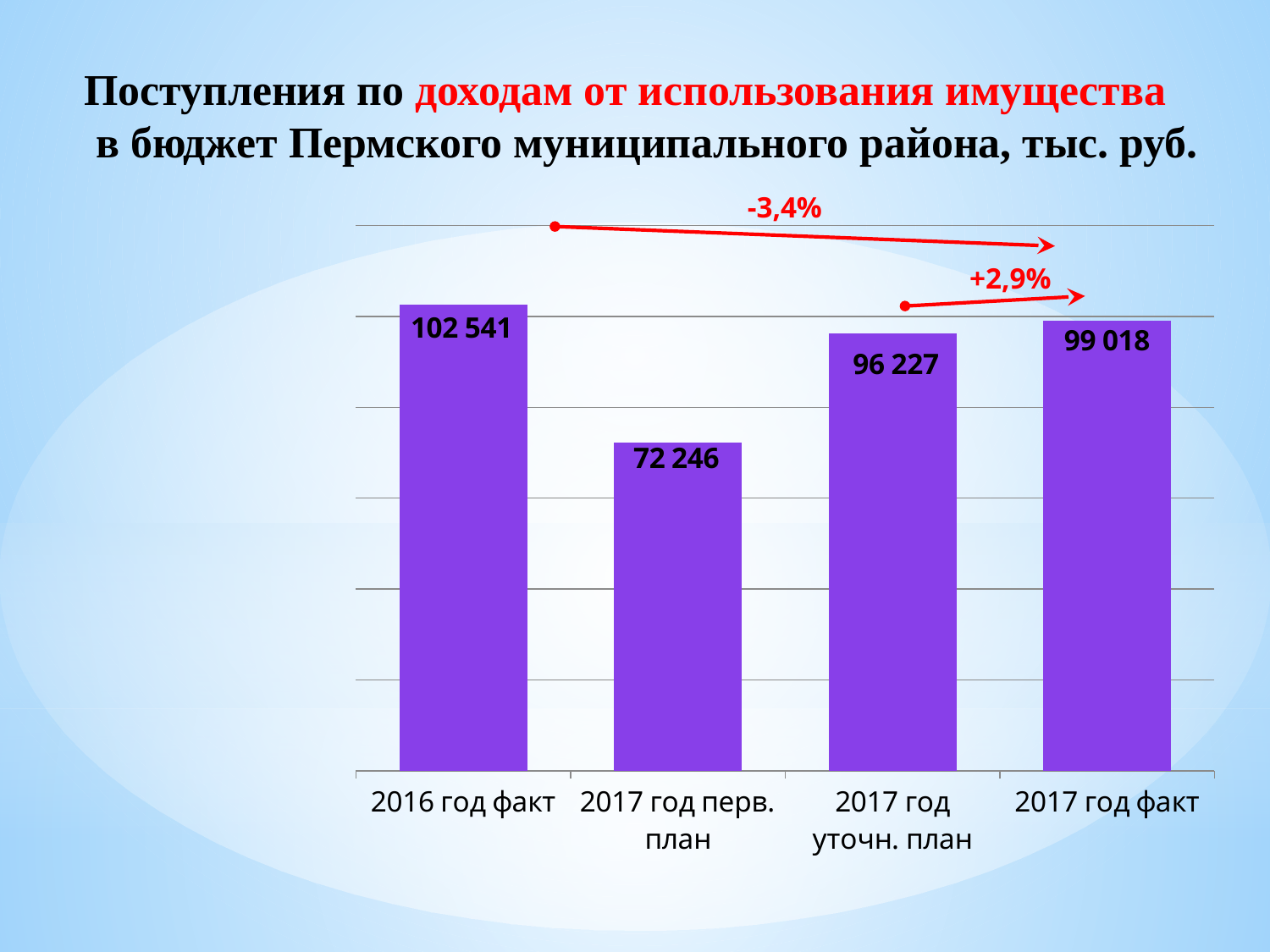
What kind of chart is shown on the slide? Bar chart What is the value for 2017 год факт? 99 018 Which category has the lowest value? 2017 год перв. план Which is larger, the value for 2017 год уточн. план or 2017 год перв. план? 2017 год уточн. план What percentage change is annotated between 2016 год факт and 2017 год факт? -3,4% Which category has the highest value? 2016 год факт What is the difference between the values for 2017 год факт and 2017 год уточн. план? 2 791 What is the difference between the values for 2016 год факт and 2017 год факт? 3 523 What is the value for 2016 год факт? 102 541 What is the value for 2017 год перв. план? 72 246 What is the value for 2017 год уточн. план? 96 227 How many categories are shown in the chart? 4